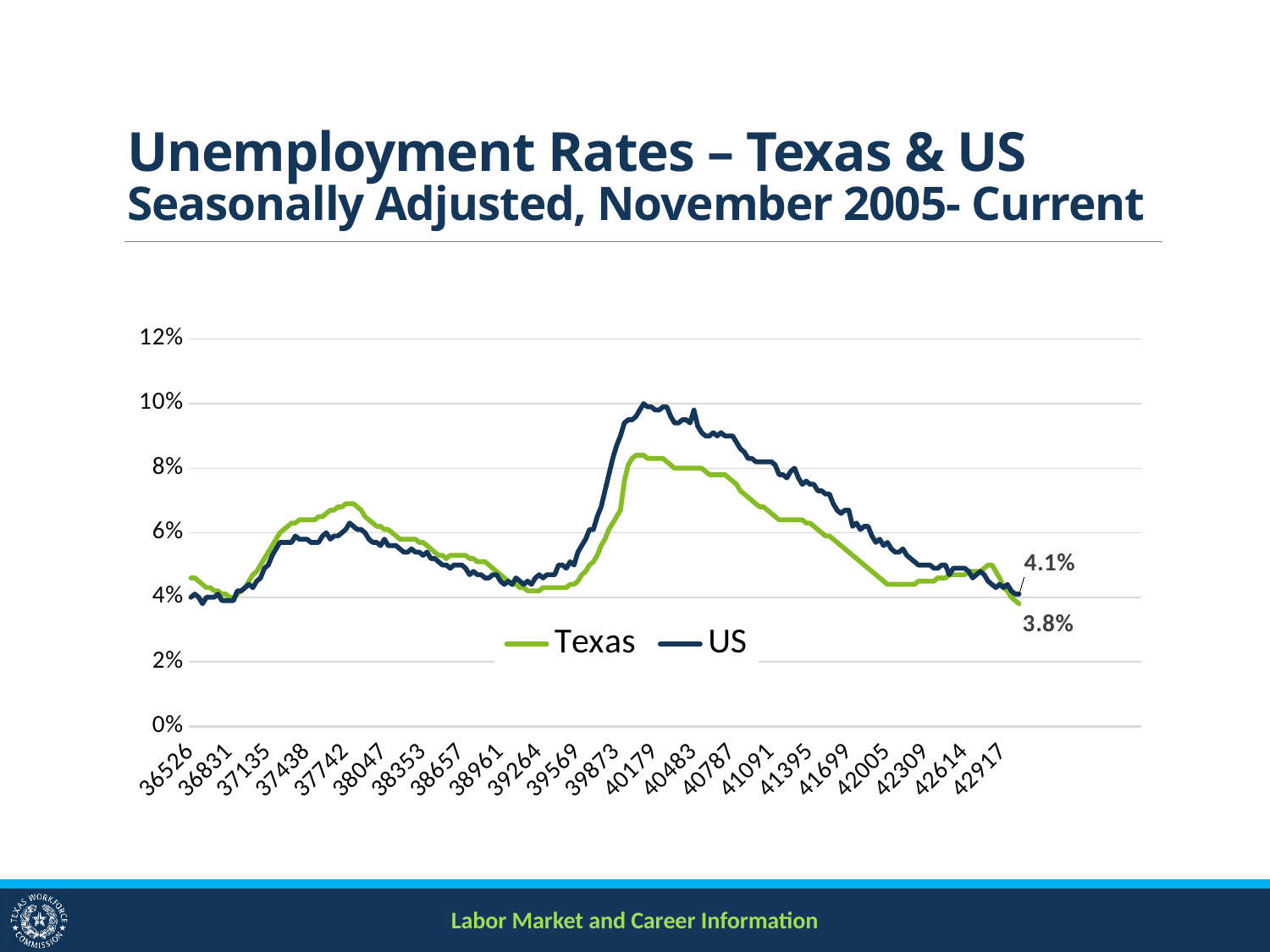
From the peak around 40179 to the end of the chart, do the unemployment rates rise or fall? fall What kind of chart is shown on the slide? line chart At the end of the series, which is higher, the Texas rate or the US rate? US Is the peak value of the US series greater or less than 8%? greater What is the title of the chart on the slide? Unemployment Rates – Texas & US, Seasonally Adjusted, November 2005- Current What is the most recent (final) unemployment rate shown for Texas? 3.8% What are the two series named in the legend? Texas and US How many series does the legend list? 2 Which series reaches the highest value anywhere on the chart? US What is the difference between the final US rate and the final Texas rate? 0.3 percentage points Is the peak value of the Texas series greater or less than 10%? less What is the most recent (final) unemployment rate shown for the US? 4.1%